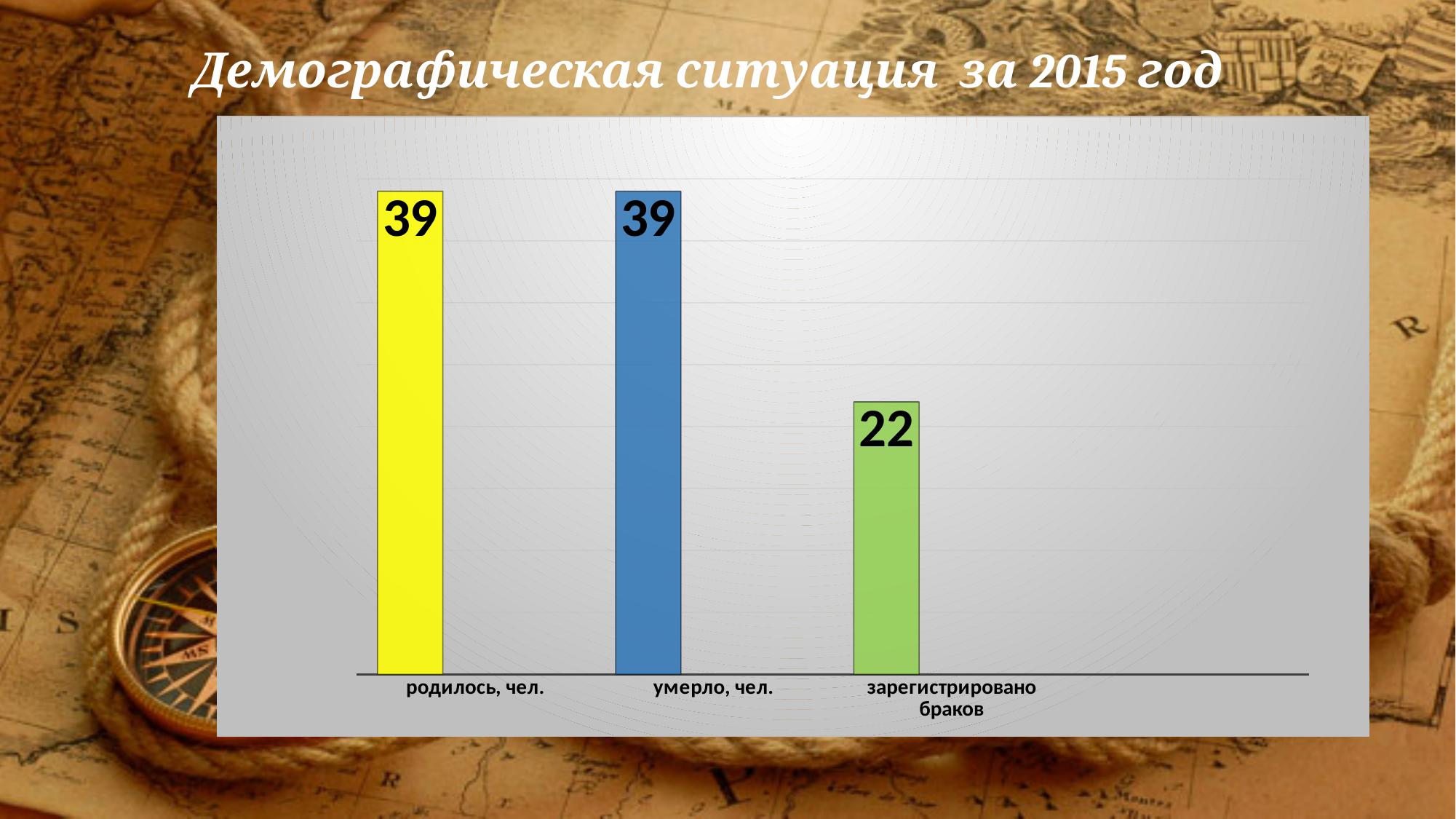
What is the difference between the value for "родилось, чел." and the value for "зарегистрировано браков"? 17 Which is larger, the value for "умерло, чел." or the value for "зарегистрировано браков"? умерло, чел. What kind of chart is shown on the slide? Bar chart Which category has the lowest value? зарегистрировано браков What is the difference between the value for "умерло, чел." and the value for "зарегистрировано браков"? 17 What is the title of the slide? Демографическая ситуация за 2015 год What is the value for "зарегистрировано браков"? 22 What colour is the bar for "зарегистрировано браков"? Green Are the values for "родилось, чел." and "умерло, чел." equal? Yes What is the value for "умерло, чел."? 39 How many categories are shown in the chart? 3 What is the value for "родилось, чел."? 39